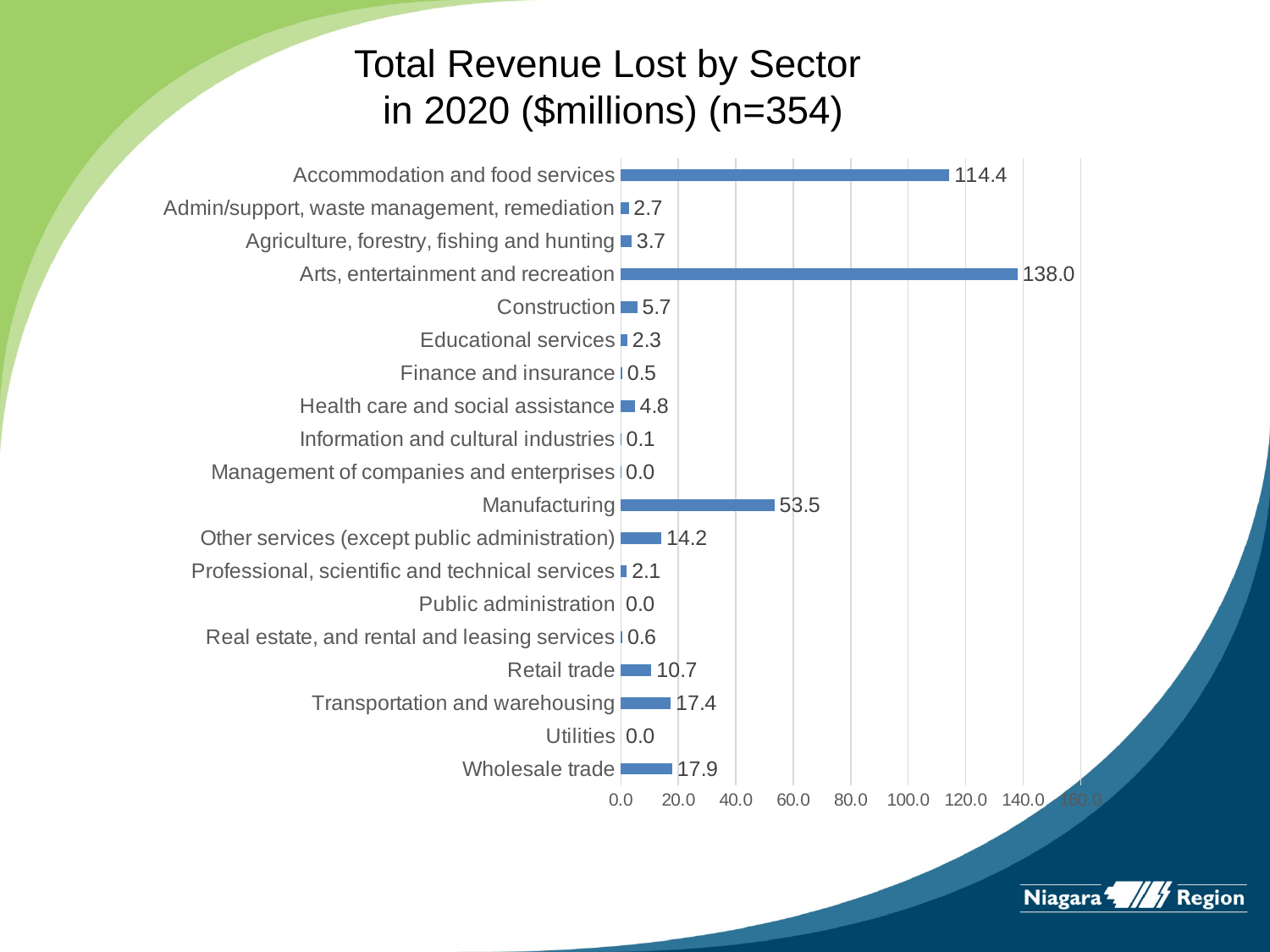
What value is shown for Manufacturing? 53.5 Is the value for Manufacturing greater or less than 60.0? less How many sectors are shown on the chart? 19 What type of chart is shown on the slide? Bar chart What is the difference between the values for Arts, entertainment and recreation and Accommodation and food services? 23.6 What is the revenue lost for Transportation and warehousing? 17.4 Which sector has the highest total revenue lost? Arts, entertainment and recreation What is the total revenue lost for Accommodation and food services? 114.4 Which is larger, the value for Construction or the value for Health care and social assistance? Construction What is the difference between Wholesale trade and Retail trade? 7.2 What is the title of the chart? Total Revenue Lost by Sector in 2020 ($millions) (n=354) How many sectors show a value of 0.0? 3